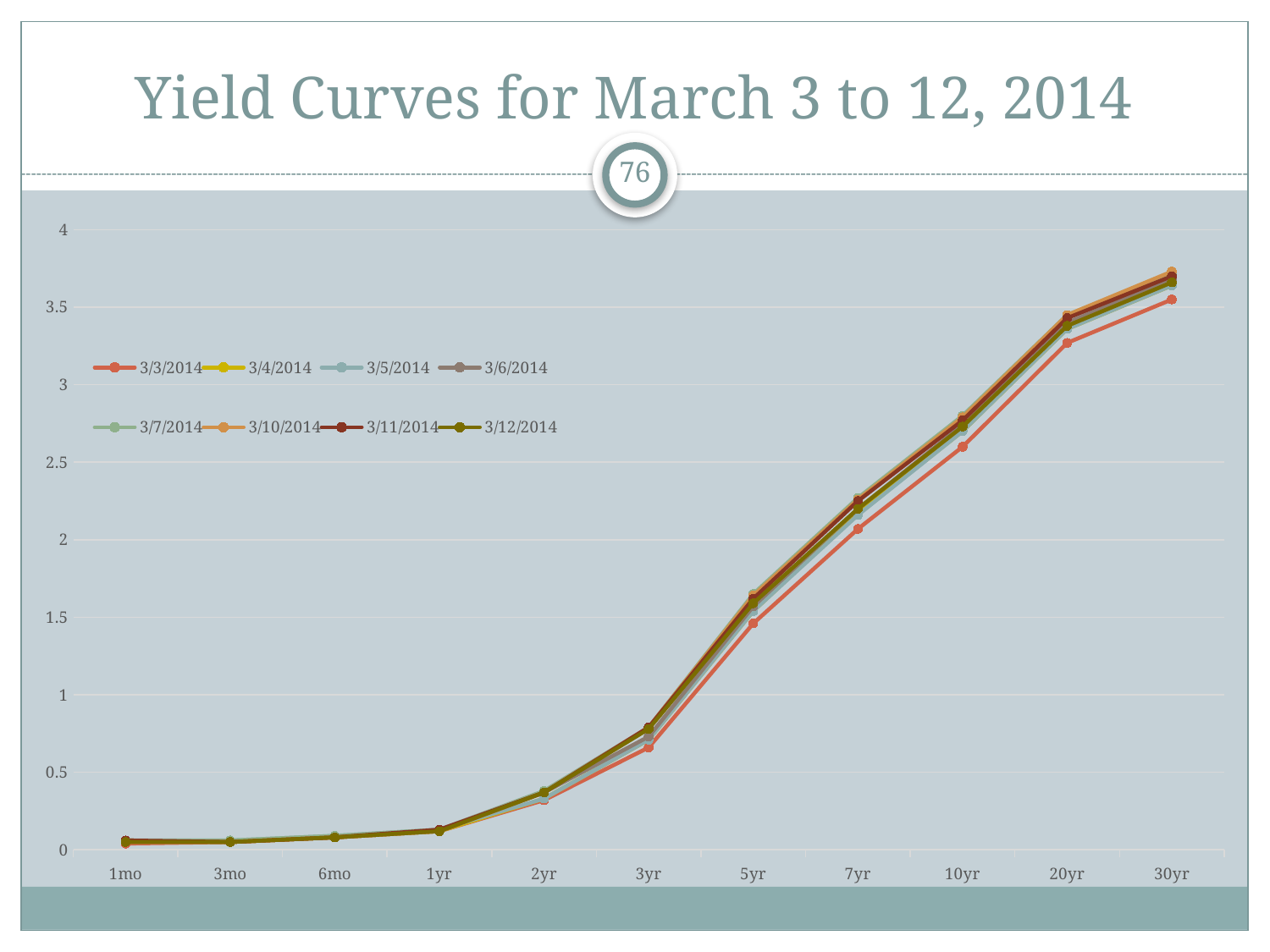
At which maturity do the yield curves reach their highest value? 30yr At the 30yr maturity, which series has the larger value, 3/3/2014 or 3/10/2014? 3/10/2014 What is the title of the chart? Yield Curves for March 3 to 12, 2014 Do the yield values rise or fall as the maturity increases from 1mo to 30yr? rise Is the value for 3/11/2014 at 7yr greater or less than 2? greater For the 3/3/2014 series, which is larger, the value at 10yr or the value at 20yr? 20yr How many maturity categories are shown on the x axis? 11 Is the value for 3/3/2014 at 20yr greater or less than 3.5? less Is the value for 3/12/2014 at 2yr greater or less than 0.5? less How many series does the legend list? 8 Which series is listed first in the legend? 3/3/2014 What kind of chart is shown on the slide? line chart